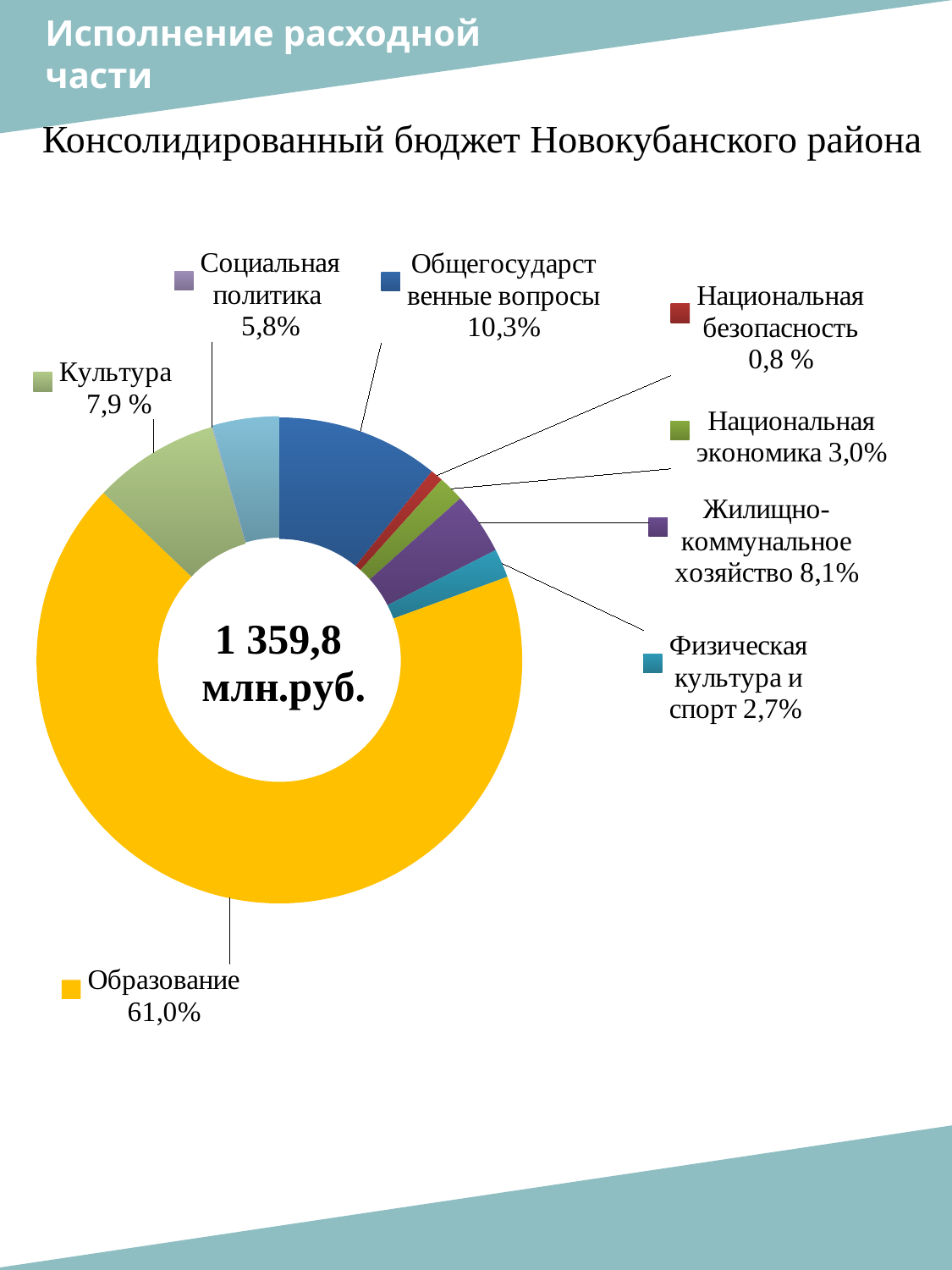
What is the difference in percentage points between Общегосударственные вопросы and Жилищно-коммунальное хозяйство? 2,2 What share of the chart does Образование account for? 61,0% Which share is larger: Культура or Социальная политика? Культура What share is shown for Общегосударственные вопросы? 10,3% What share is shown for Жилищно-коммунальное хозяйство? 8,1% Which category has the largest share of the chart? Образование What kind of chart is shown on the slide? Doughnut (pie) chart How many categories are shown in the chart? 8 Which category has the smallest share of the chart? Национальная безопасность What is the title printed above the chart? Консолидированный бюджет Новокубанского района What total value is printed in the centre of the chart? 1 359,8 млн.руб.